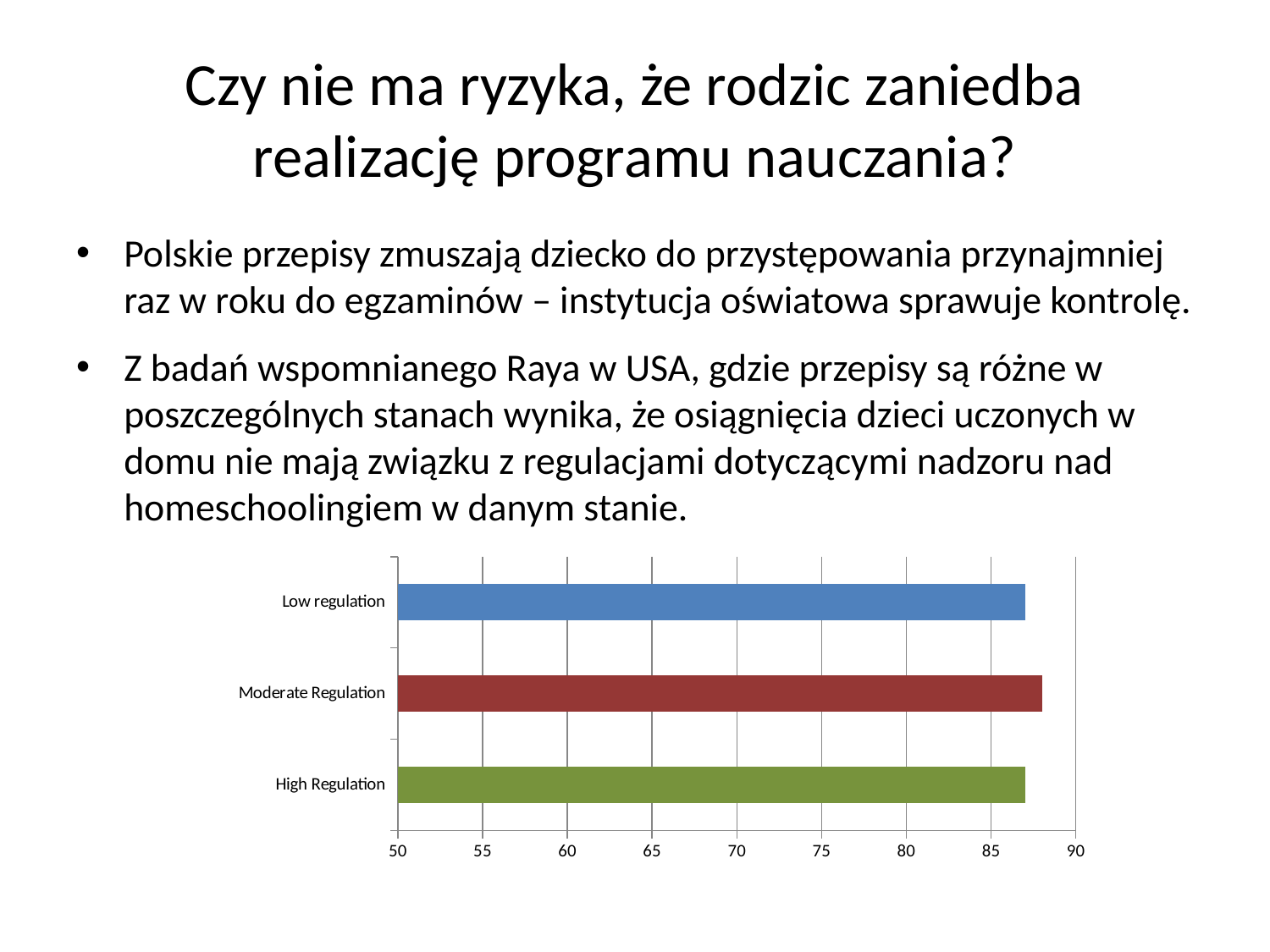
Is the value for High Regulation greater or less than 85? greater Which category is listed at the top of the chart? Low regulation What kind of chart is shown on the slide? bar chart Is the value for High Regulation greater or less than 80? greater How many categories does the chart show? 3 What colour is the bar for Moderate Regulation? red Is the value for Moderate Regulation greater or less than 90? less